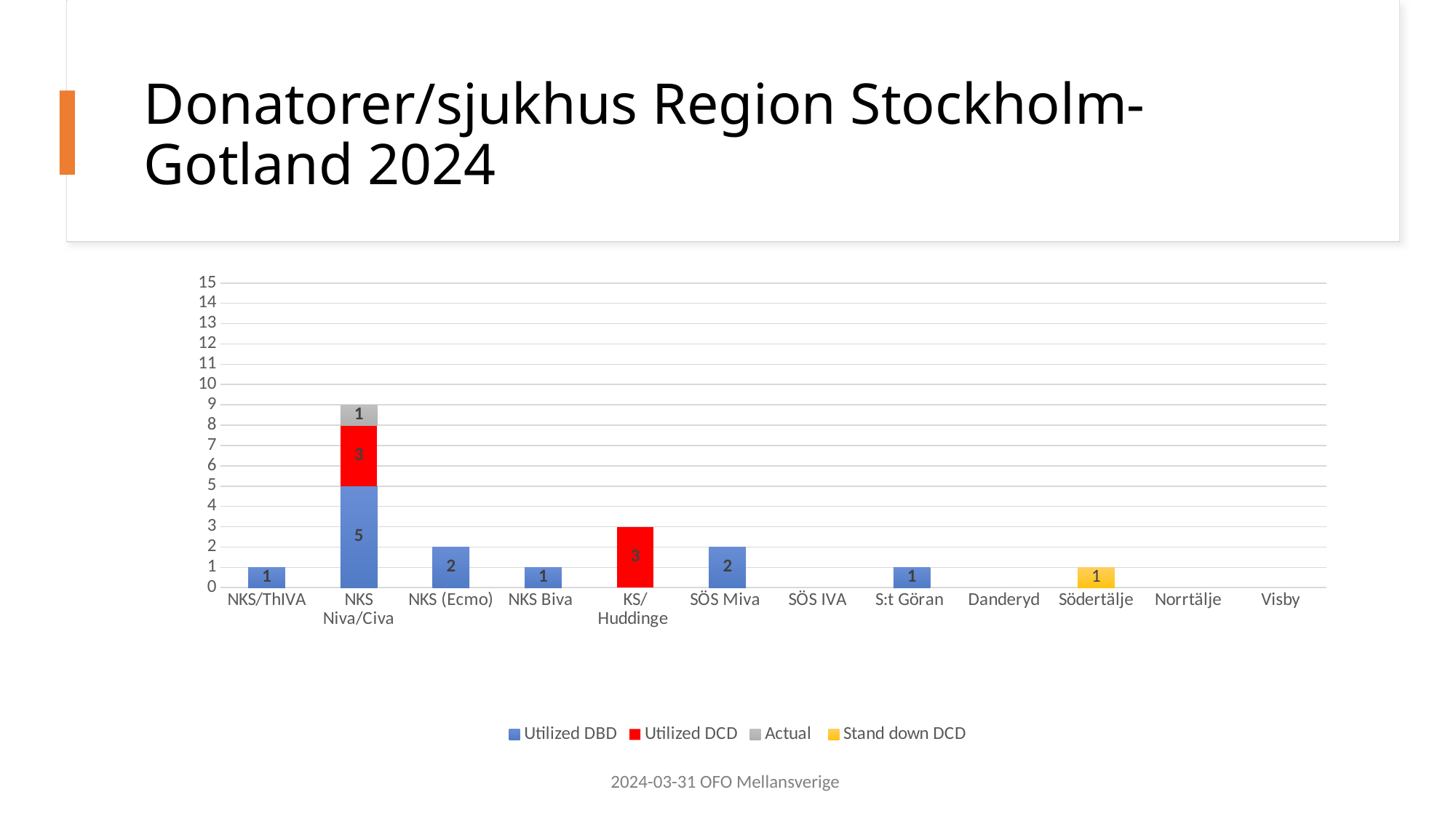
What type of chart is shown on the slide? Stacked bar chart What is the Actual value for NKS Niva/Civa? 1 Which is larger, the Utilized DBD value for SÖS Miva or for S:t Göran? SÖS Miva Which series is shown in red in the legend? Utilized DCD How many hospital categories are shown on the x axis? 12 What is the Stand down DCD value for Södertälje? 1 What is the Utilized DBD value for NKS Niva/Civa? 5 Which hospital has the highest total bar? NKS Niva/Civa What is the difference between the Utilized DBD values for NKS Niva/Civa and NKS (Ecmo)? 3 How many series does the legend list? 4 What is the total of the stacked bar for NKS Niva/Civa? 9 What is the Utilized DCD value for KS/Huddinge? 3